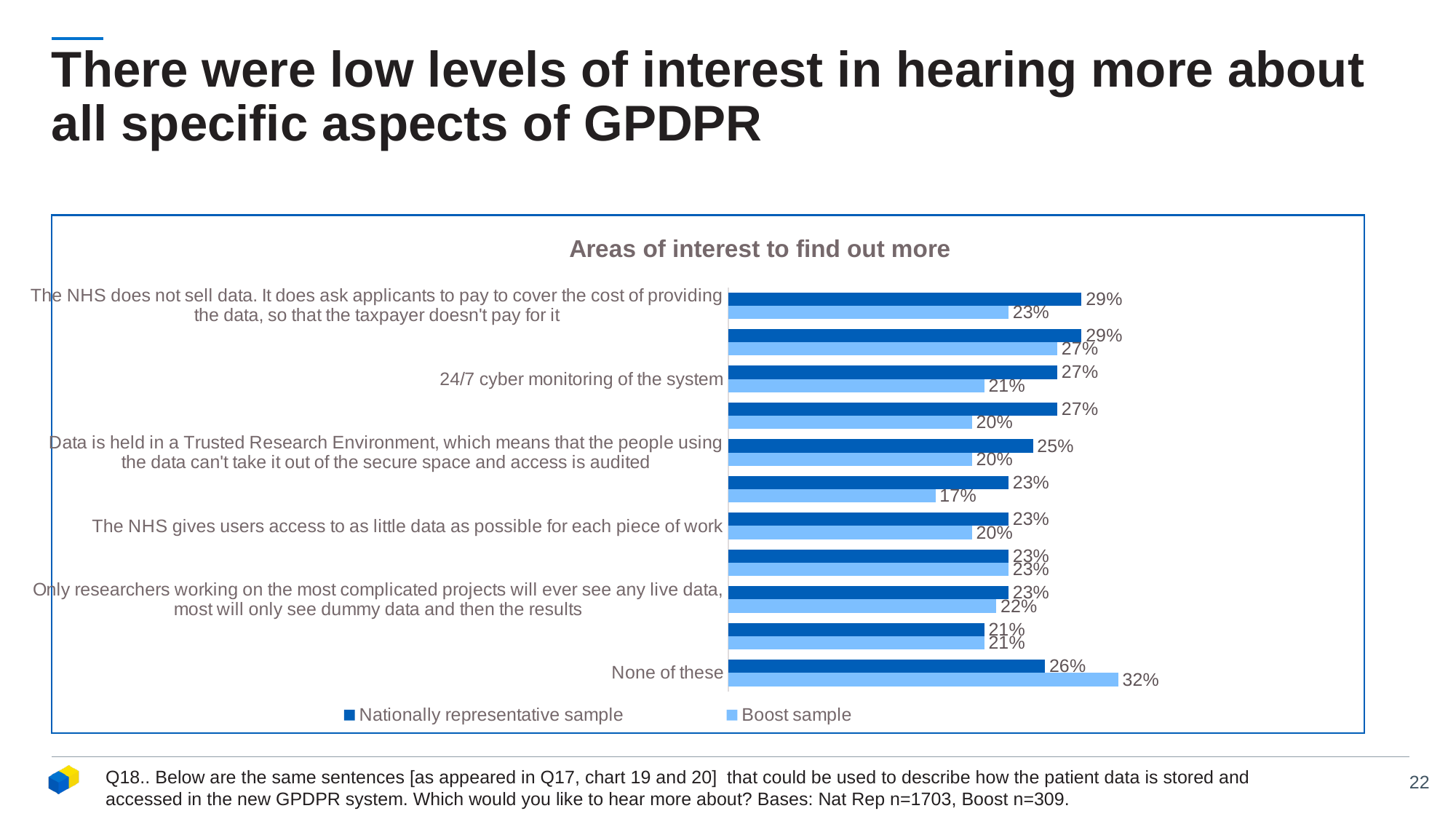
What is the Boost sample value for 'None of these'? 32% For '24/7 cyber monitoring of the system', what is the difference between the Nationally representative sample and the Boost sample? 6 percentage points What is the Nationally representative sample value for 'The NHS gives users access to as little data as possible for each piece of work'? 23% What is the Boost sample value for 'The NHS does not sell data. It does ask applicants to pay to cover the cost of providing the data, so that the taxpayer doesn't pay for it'? 23% What type of chart is shown on the slide? Bar chart Which category has the highest Boost sample value? None of these What is the title of the chart? Areas of interest to find out more What percentage of the Nationally representative sample wanted to hear more about '24/7 cyber monitoring of the system'? 27% What is the Boost sample value for 'Only researchers working on the most complicated projects will ever see any live data, most will only see dummy data and then the results'? 22% For 'None of these', how many percentage points higher is the Boost sample than the Nationally representative sample? 6 percentage points How many series does the legend list? 2 For 'Data is held in a Trusted Research Environment, which means that the people using the data can't take it out of the secure space and access is audited', which sample has the higher value? Nationally representative sample